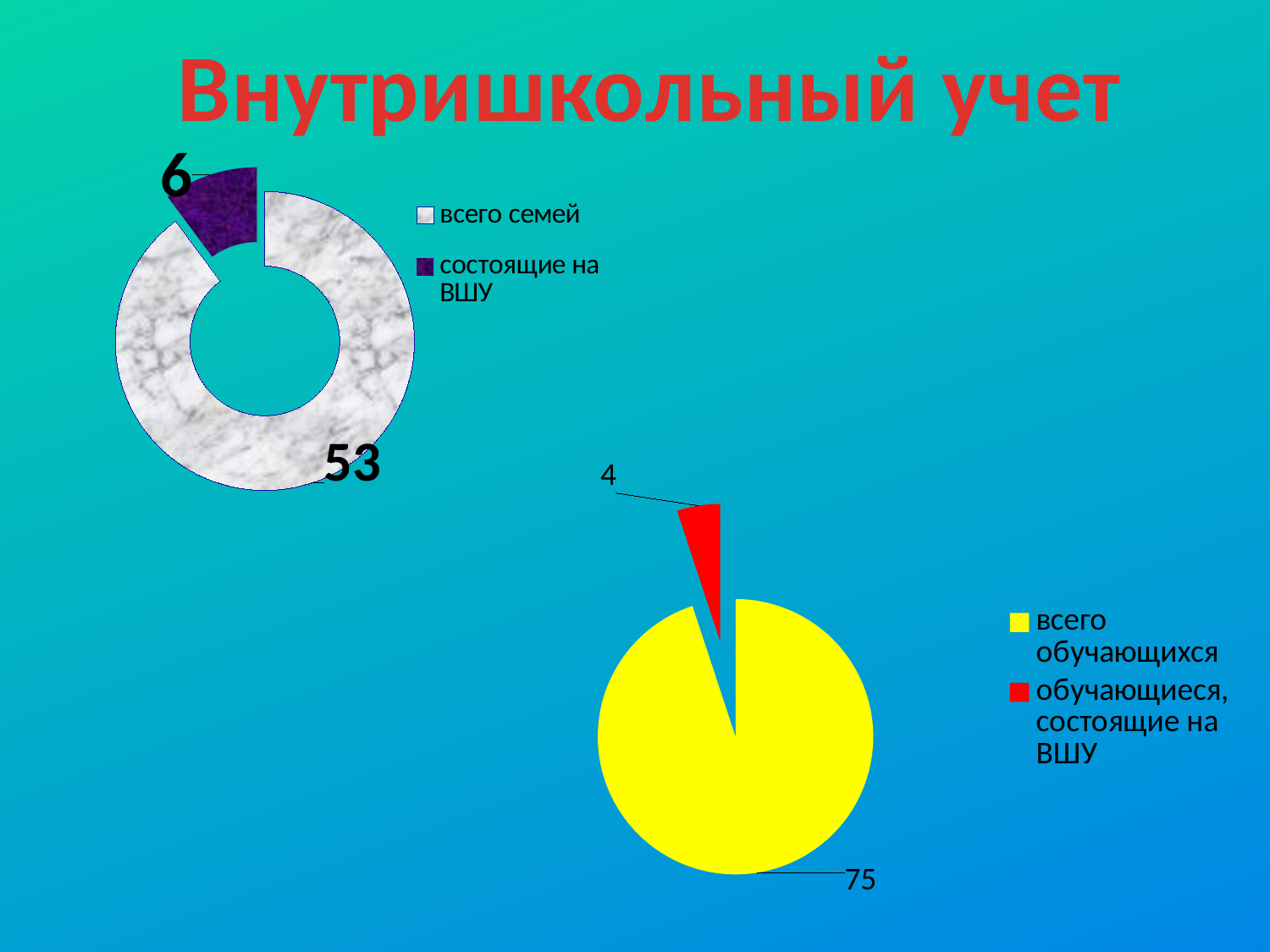
In the bottom-right pie chart, what is the value for "всего обучающихся"? 75 In the top-left doughnut chart, which category has the largest value? всего семей In the bottom-right pie chart, which is larger: "всего обучающихся" or "обучающиеся, состоящие на ВШУ"? всего обучающихся In the top-left doughnut chart, what is the difference between the values for "всего семей" and "состоящие на ВШУ"? 47 In the bottom-right pie chart, which category has the smallest value? обучающиеся, состоящие на ВШУ In the top-left doughnut chart, what is the value for "состоящие на ВШУ"? 6 What type of chart is the bottom-right chart? Pie chart How many categories does the top-left doughnut chart show? 2 In the bottom-right pie chart, what is the difference between the values for "всего обучающихся" and "обучающиеся, состоящие на ВШУ"? 71 In the top-left doughnut chart, what is the value for "всего семей"? 53 In the bottom-right pie chart, what colour is the slice for "всего обучающихся"? Yellow In the bottom-right pie chart, what is the value for "обучающиеся, состоящие на ВШУ"? 4